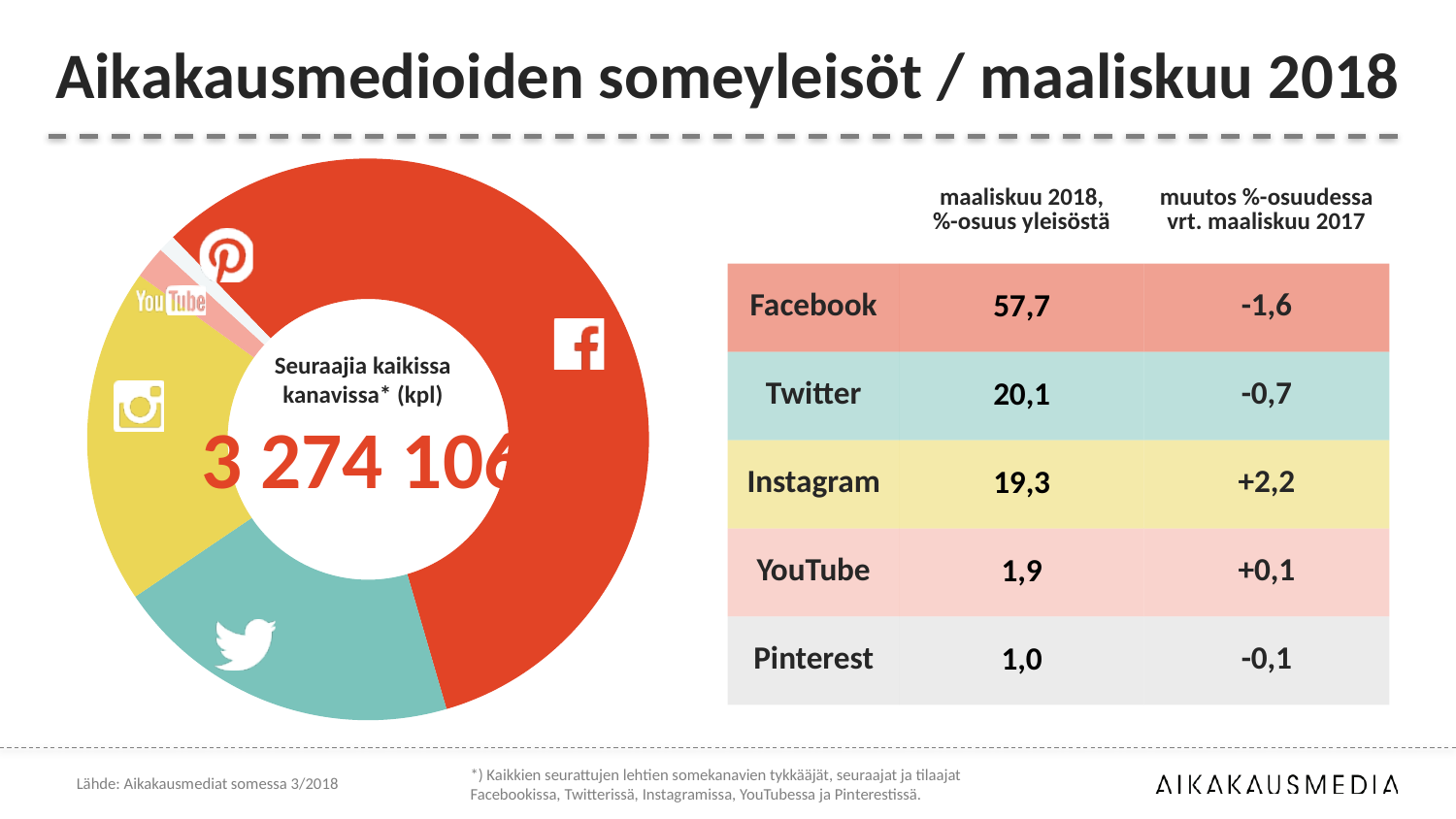
What is the difference in %-share between Facebook and Twitter? 37,6 Which channel has the largest share of the audience? Facebook What is YouTube's %-share of the audience in March 2018? 1,9 What is the difference in %-share between Instagram and YouTube? 17,4 What is the change in %-share for Instagram compared to March 2017? +2,2 Which channel has the smallest share of the audience? Pinterest How many social media channels are shown as slices in the pie chart? 5 What is the total number of followers across all channels shown in the centre of the pie chart? 3 274 106 Which channel is represented by the red slice of the pie chart? Facebook Which has a larger %-share of the audience, Twitter or Instagram? Twitter What kind of chart is shown on the left of the slide? pie chart (donut) What is Facebook's %-share of the audience in March 2018? 57,7